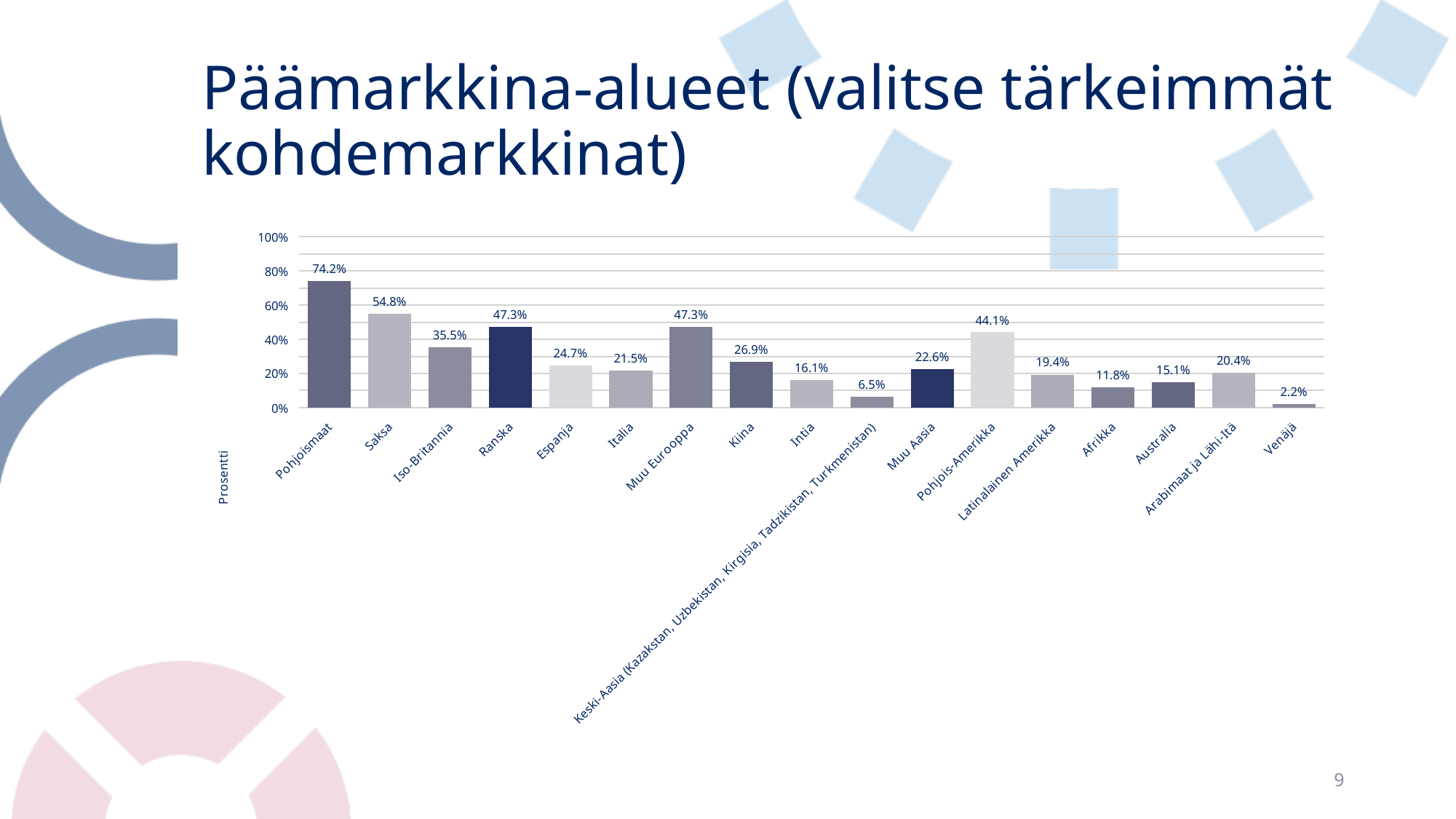
What is the difference between the values for Pohjoismaat and Saksa? 19.4% What is the value for Pohjoismaat? 74.2% Which category has the highest value? Pohjoismaat Which is larger, the value for Afrikka or the value for Australia? Australia How many categories are shown on the x axis? 17 Which is larger, the value for Espanja or the value for Italia? Espanja What is the difference between the values for Ranska and Iso-Britannia? 11.8% What is the value for Pohjois-Amerikka? 44.1% What kind of chart is shown on the slide? bar chart Is the value for Saksa greater or less than 60%? less What is the value for Kiina? 26.9% Which category has the lowest value? Venäjä